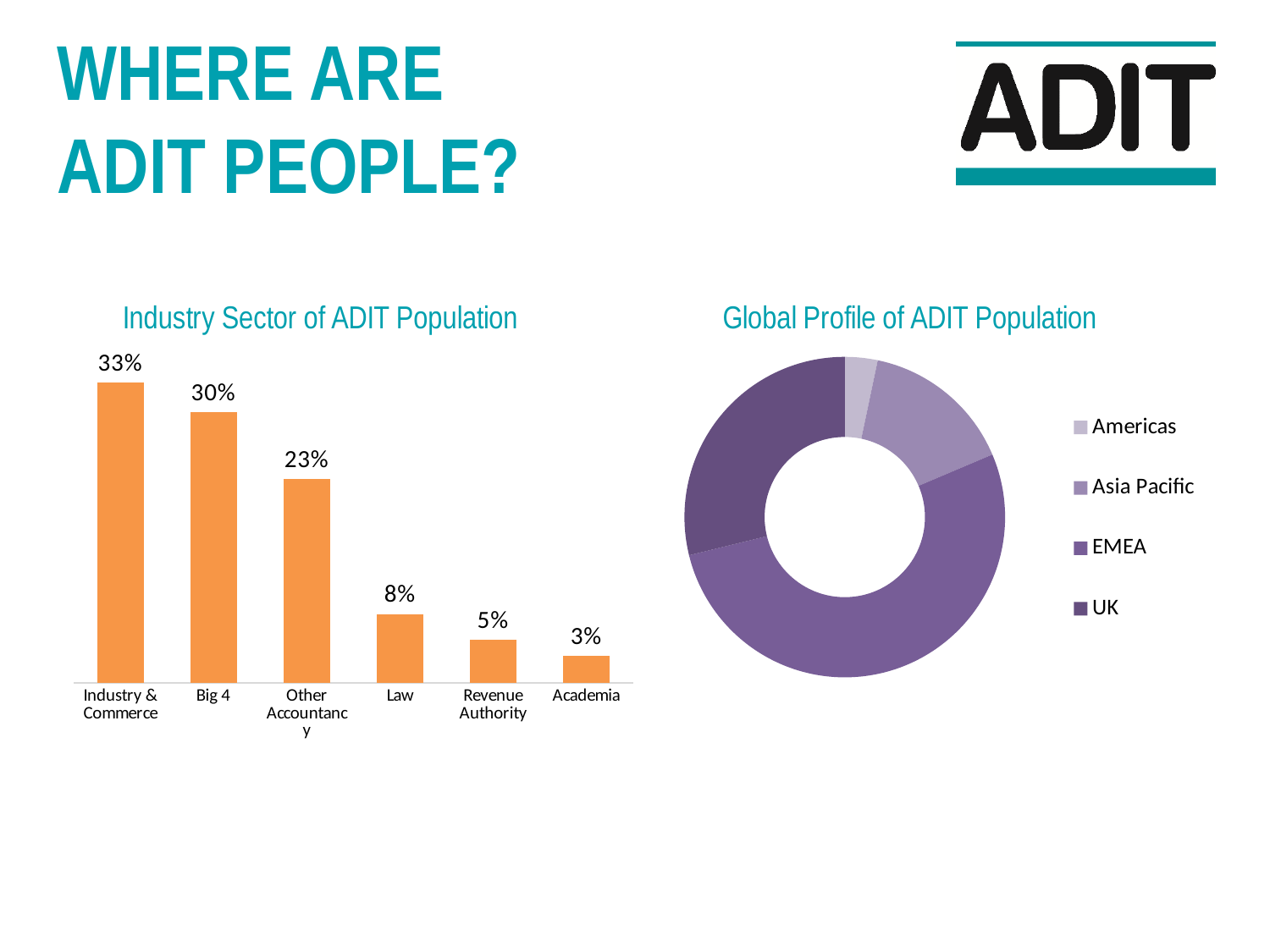
In the Global Profile of ADIT Population chart, which region has the smallest share? Americas In the Industry Sector of ADIT Population chart, which is larger, Law or Revenue Authority? Law How many sectors are shown in the Industry Sector of ADIT Population chart? 6 In the Industry Sector of ADIT Population chart, which sector has the highest value? Industry & Commerce What kind of chart is the Industry Sector of ADIT Population chart? Bar chart In the Industry Sector of ADIT Population chart, what is the value for Revenue Authority? 5% In the Industry Sector of ADIT Population chart, what is the difference between Industry & Commerce and Other Accountancy? 10% In the Industry Sector of ADIT Population chart, which sector has the lowest value? Academia In the Industry Sector of ADIT Population chart, what is the value for Big 4? 30% In the Industry Sector of ADIT Population chart, what is the value for Law? 8% In the Global Profile of ADIT Population chart, which region has the largest share? EMEA How many regions does the legend of the Global Profile of ADIT Population chart list? 4